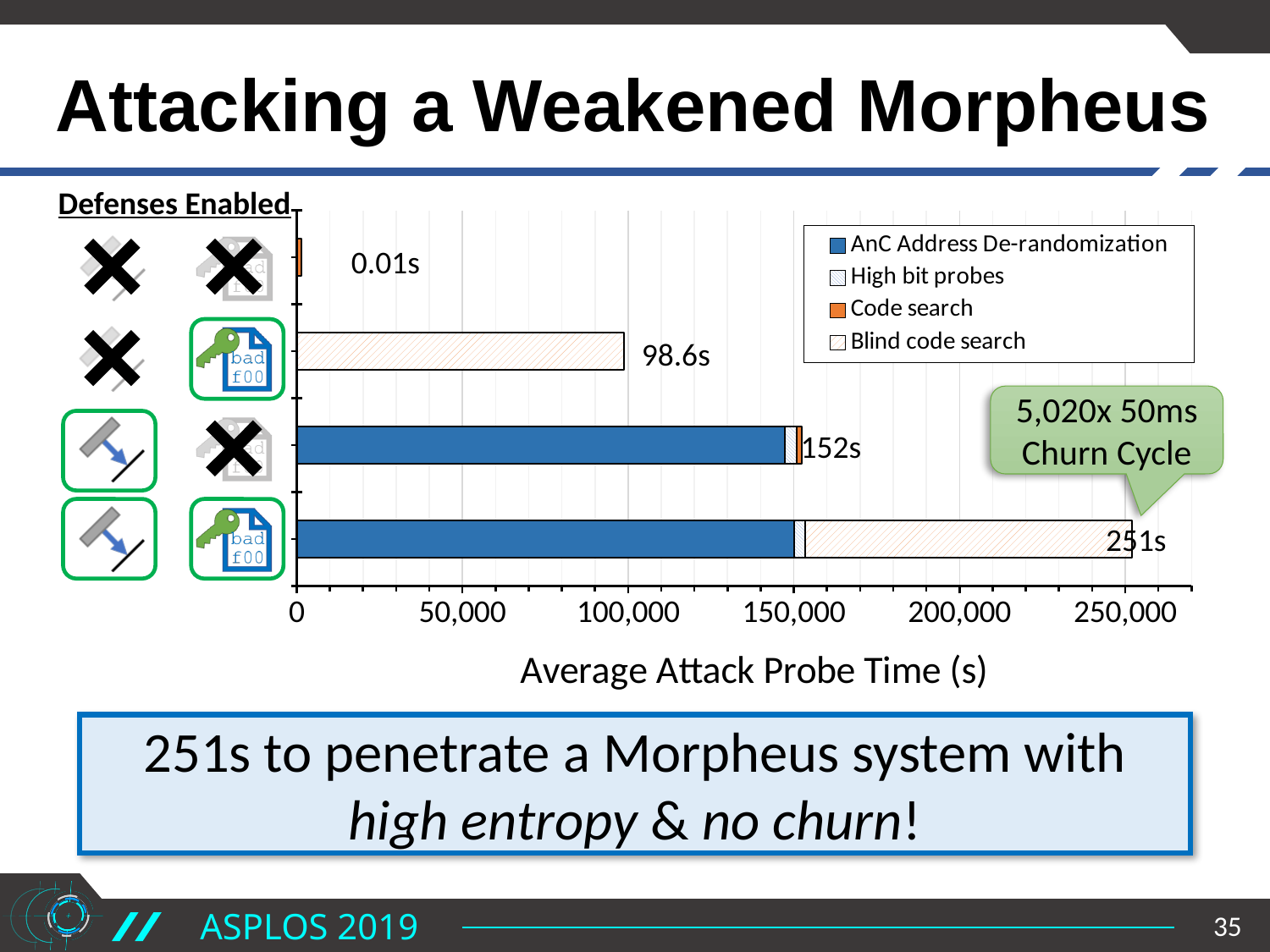
How many bars are plotted in the chart? 4 How many series does the chart legend list? 4 What is the difference between the labelled values of the bottom bar (251s) and the third bar from the top (152s)? 99s What is the title of the chart's x axis? Average Attack Probe Time (s) What is the data label on the second bar from the top? 98.6s What is the data label on the top bar of the chart? 0.01s Which bar has the highest average attack probe time? the bottom bar (251s) What is the data label on the bottom bar of the chart? 251s Which bar has the lowest average attack probe time? the top bar (0.01s) Which is larger, the value of the second bar from the top or the third bar from the top? the third bar from the top (152s) Is the bottom bar's length on the x axis greater or less than 200,000? greater What kind of chart is shown on the slide? bar chart